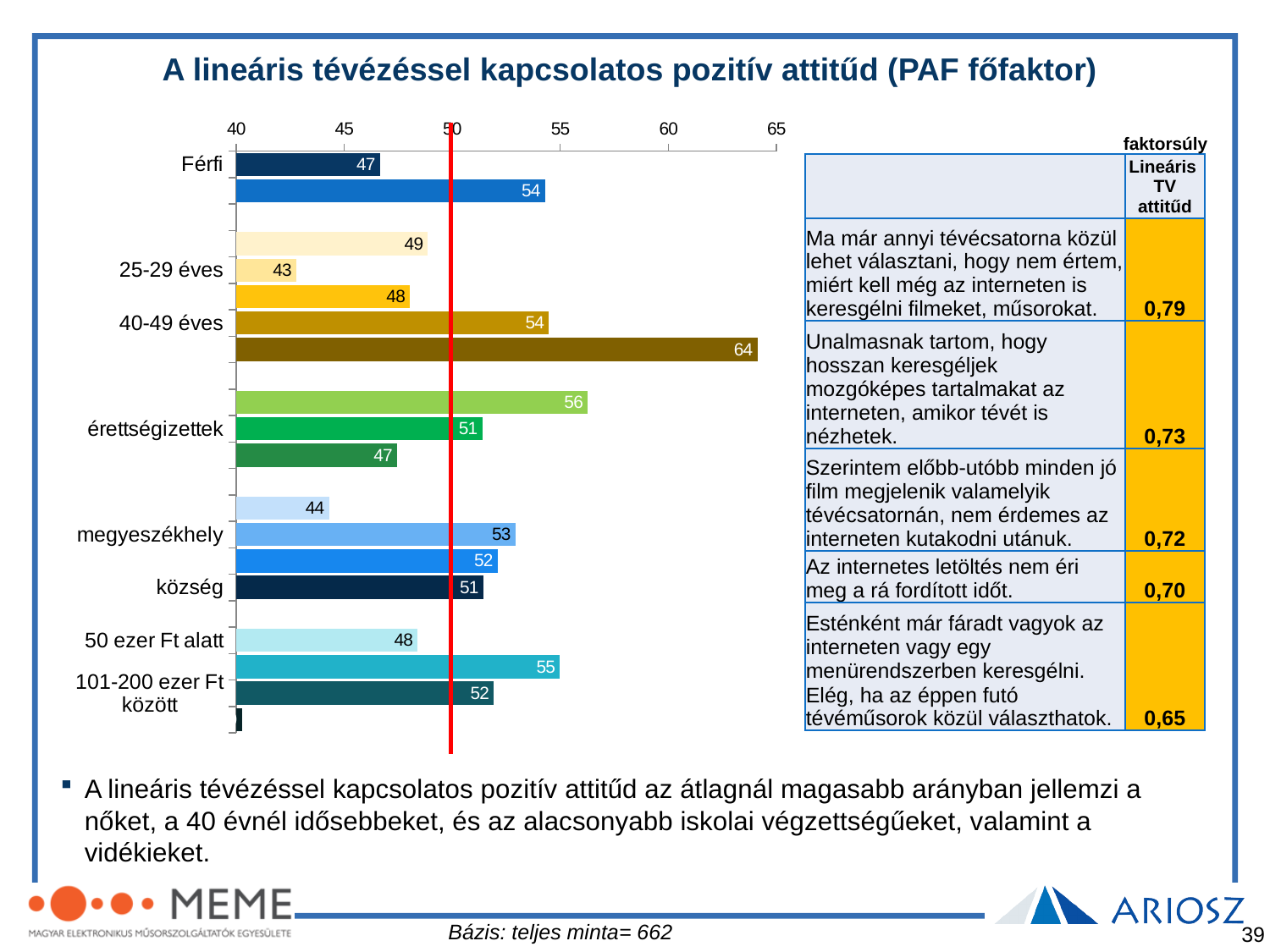
What is the value for 40-49 éves? 54 Which has the larger value, megyeszékhely or 50 ezer Ft alatt? megyeszékhely What is the largest value labeled on any bar in the chart? 64 What is the value for megyeszékhely? 53 What is the value for 101-200 ezer Ft között? 52 What is the value for 50 ezer Ft alatt? 48 What is the value for község? 51 What is the value for érettségizettek? 51 What is the value for 25-29 éves? 43 What is the value for Férfi? 47 What is the difference between the values for 40-49 éves and 25-29 éves? 11 What kind of chart is shown on the slide? bar chart